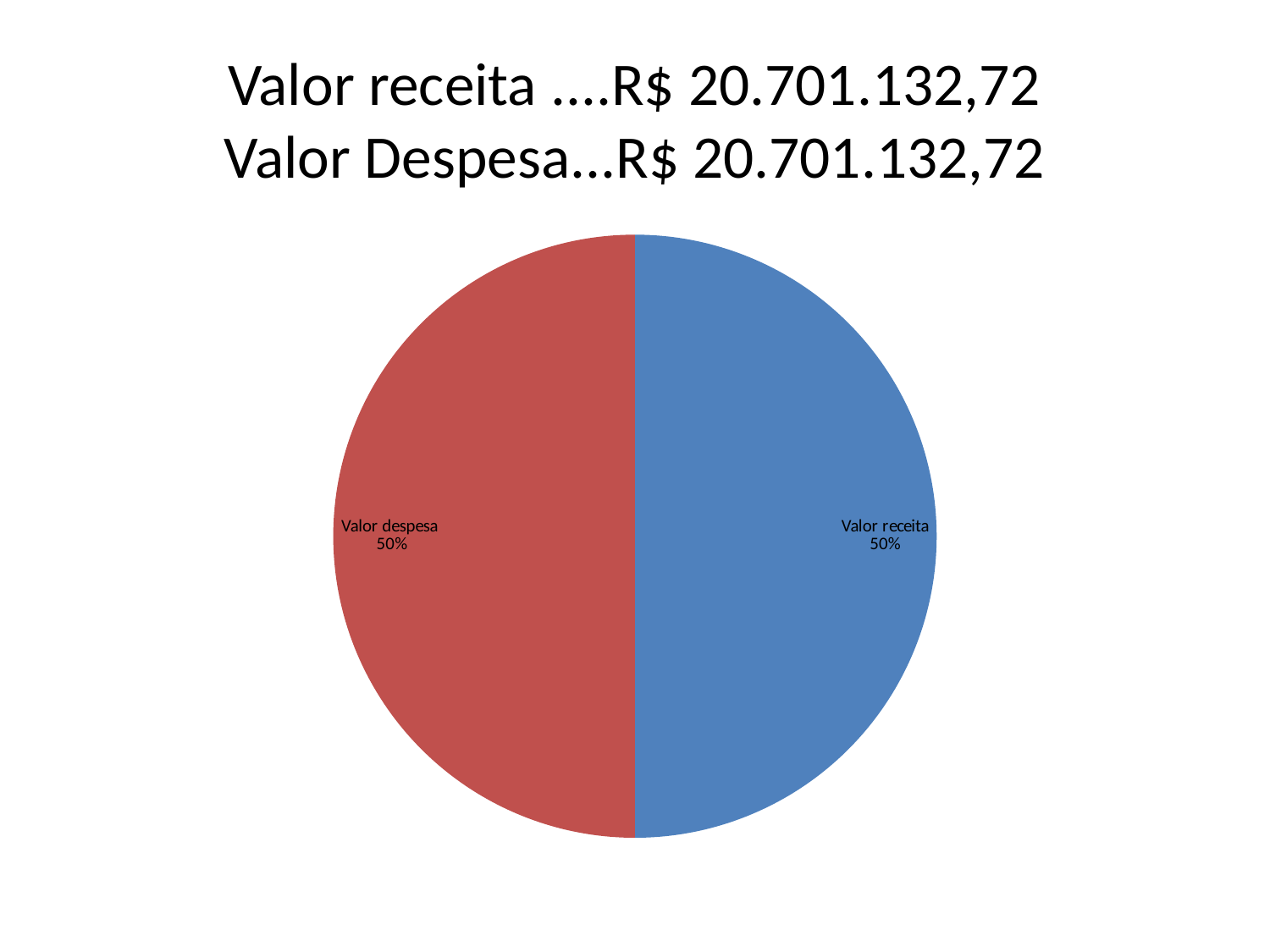
What is the difference between the shares of "Valor receita" and "Valor despesa"? 0% What colour is the "Valor receita" slice? blue What share of the pie does the "Valor despesa" slice represent? 50% What share of the pie does the "Valor receita" slice represent? 50% How many slices does the pie chart have? 2 According to the slide title, what is the value of "Valor receita"? R$ 20.701.132,72 What colour is the "Valor despesa" slice? red What kind of chart is shown on the slide? pie chart According to the slide title, what is the value of "Valor Despesa"? R$ 20.701.132,72 What is the combined share of the "Valor receita" and "Valor despesa" slices? 100%